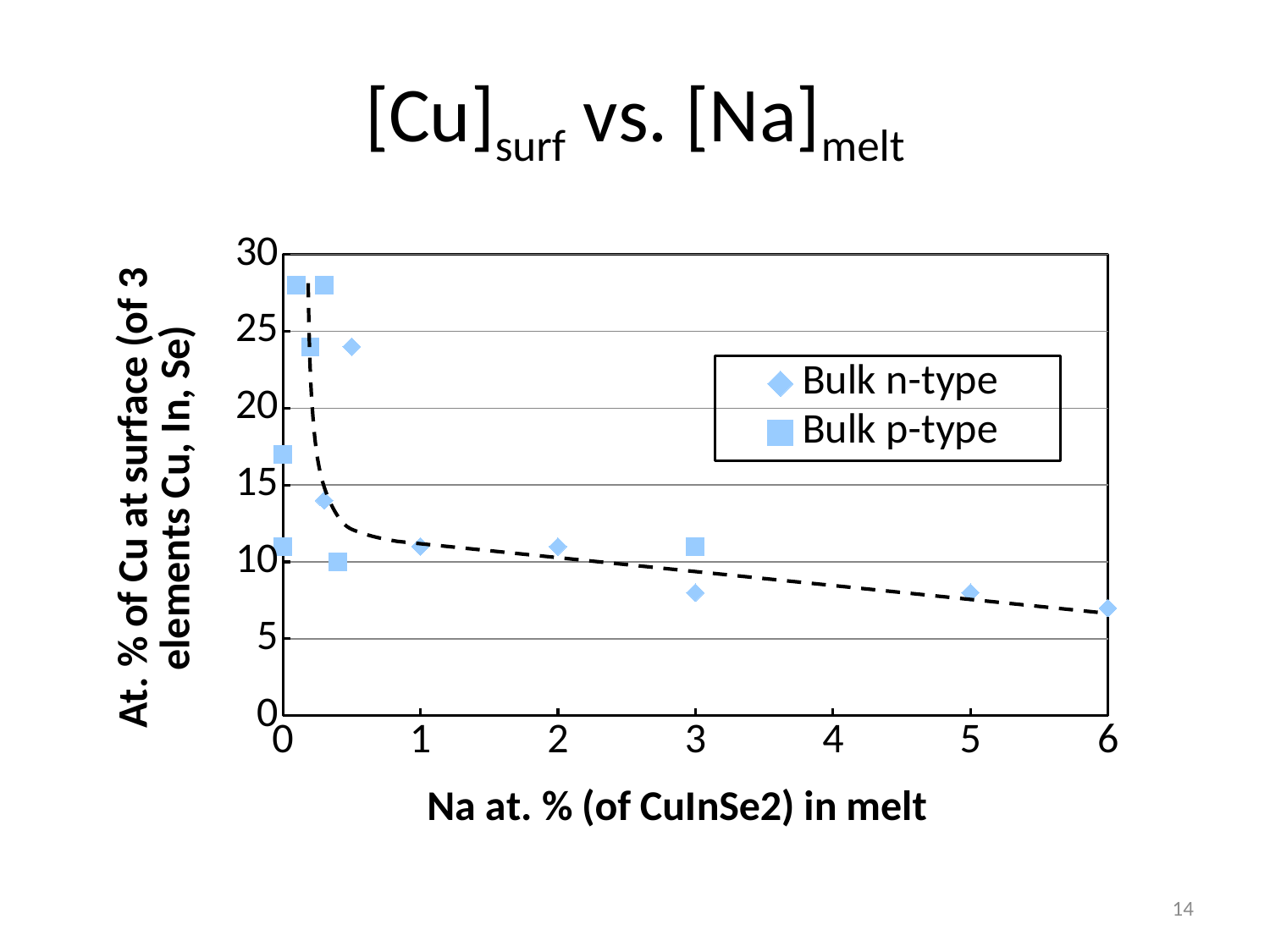
Is the Bulk n-type value at Na at. % of 6 greater or less than 10? less How many series does the legend list? 2 Are the highest Bulk p-type values greater or less than 25? greater What is the label of the x axis? Na at. % (of CuInSe2) in melt What is the maximum value shown on the x axis? 6 Is the Bulk p-type value at Na at. % of 3 greater or less than 15? less Which is larger: the Bulk n-type value at Na at. % of 1 or at Na at. % of 6? Na at. % of 1 What kind of chart is shown on the slide? scatter chart What are the two series named in the legend? Bulk n-type and Bulk p-type Which series contains the highest plotted value on the chart? Bulk p-type Do the Bulk n-type values generally rise or fall as Na at. % in the melt increases? fall